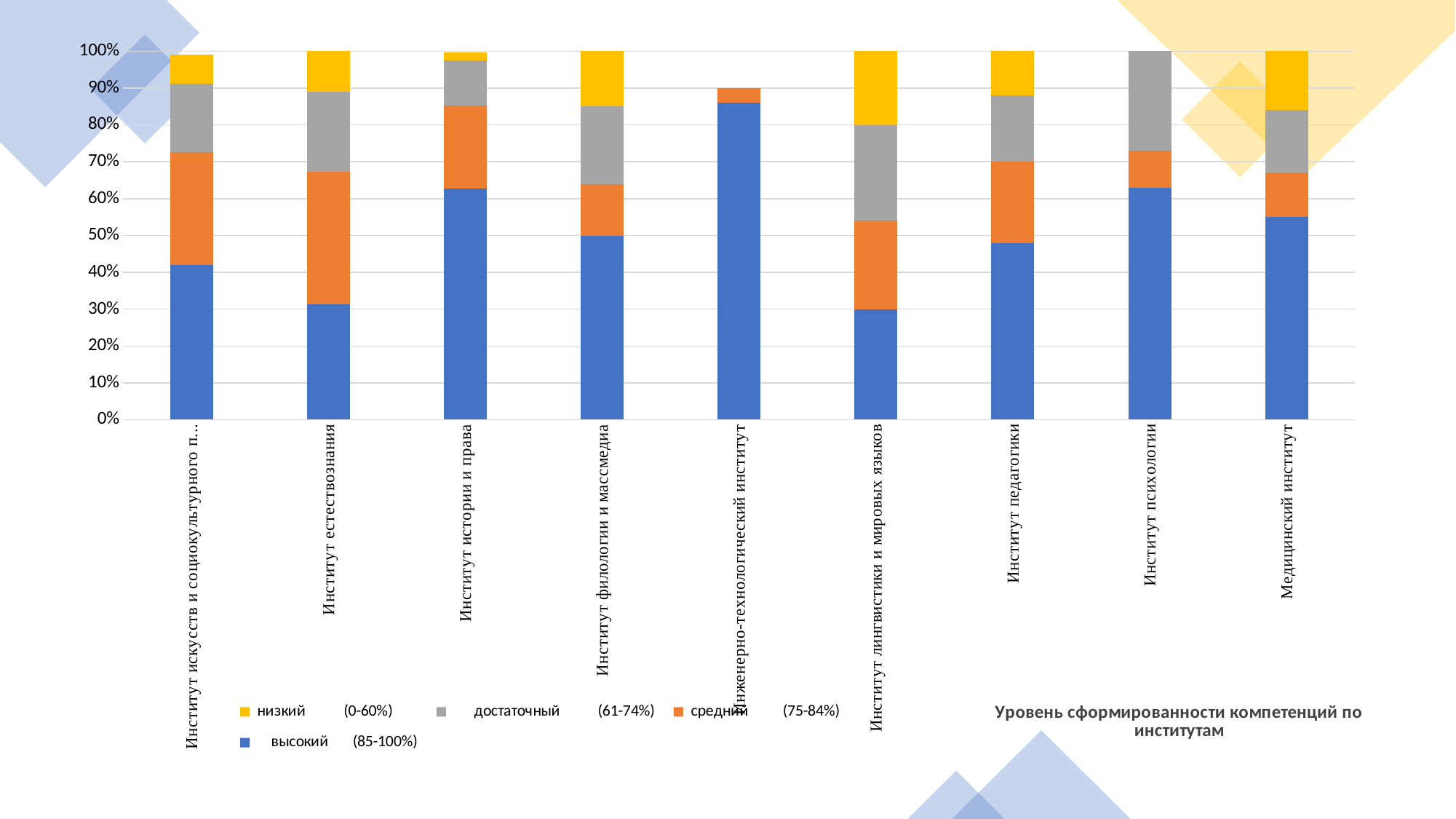
What is the title of the chart? Уровень сформированности компетенций по институтам How many institutes (categories) are shown on the x axis of the chart? 9 Which has a larger 'высокий (85-100%)' value: Медицинский институт or Институт естествознания? Медицинский институт Which has a larger 'высокий (85-100%)' value: Институт педагогики or Институт психологии? Институт психологии Is the 'высокий (85-100%)' value for Институт лингвистики и мировых языков greater or less than 40%? less Is the 'высокий (85-100%)' value for Институт истории и права greater or less than 50%? greater Is the 'высокий (85-100%)' value for Инженерно-технологический институт greater or less than 80%? greater Which colour represents the 'низкий (0-60%)' series in the chart legend? Yellow How many series does the chart legend list? 4 Which institute has the highest value for the 'высокий (85-100%)' series? Инженерно-технологический институт What kind of chart is shown on the slide? Stacked bar chart